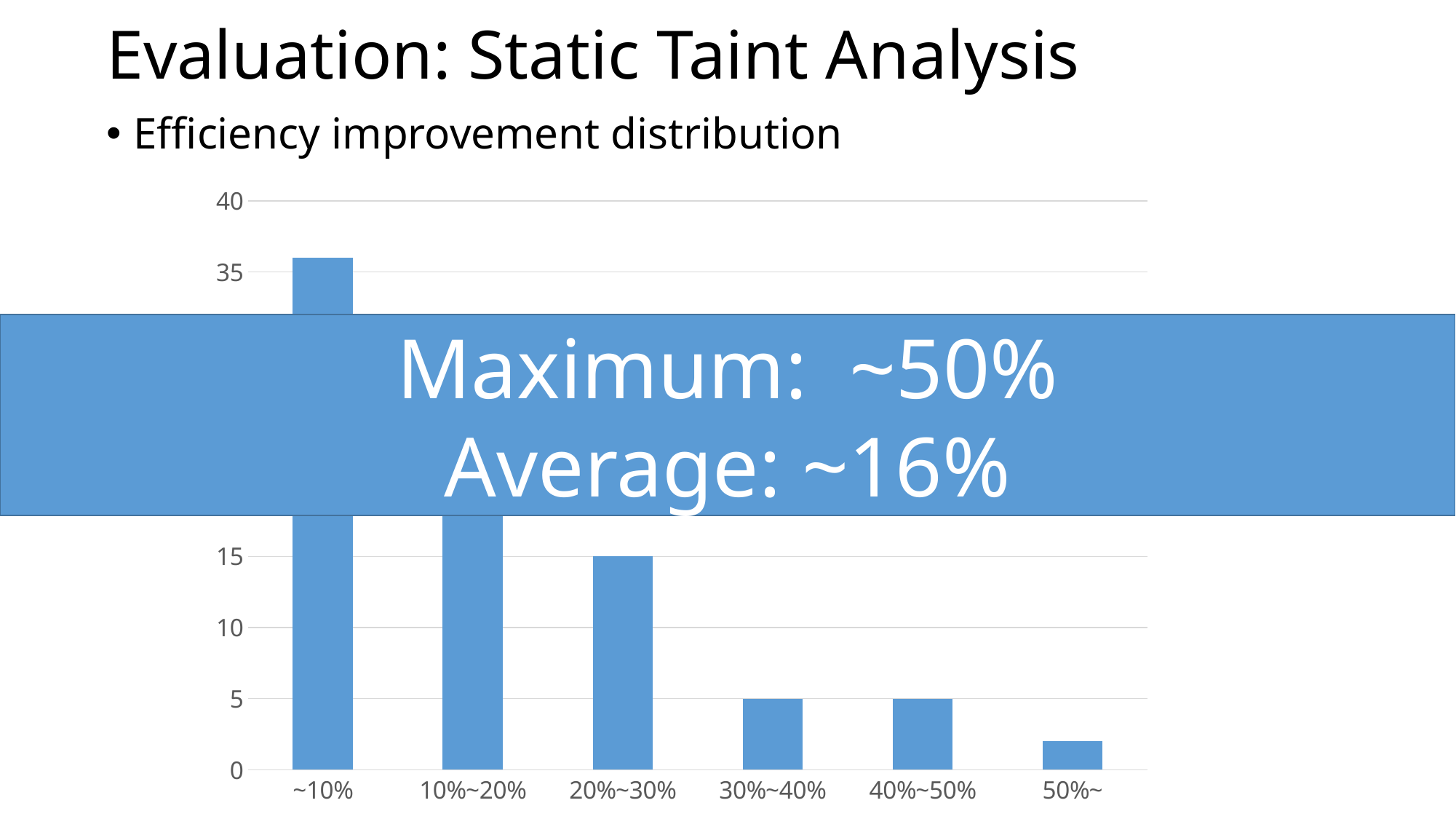
What is the difference between the values for 20%~30% and 30%~40%? 10 Which is larger, the value for ~10% or the value for 20%~30%? ~10% Is the value for 50%~ greater or less than 5? less Which category has the lowest bar? 50%~ How many categories are shown on the x axis of the chart? 6 Is the value for ~10% greater or less than 35? greater What is the value for the 30%~40% category? 5 What is the value for the 20%~30% category? 15 What kind of chart is shown on the slide? bar chart What is the value for the 40%~50% category? 5 What average efficiency improvement is stated in the overlay text on the chart? ~16% Which category has the highest bar? ~10%